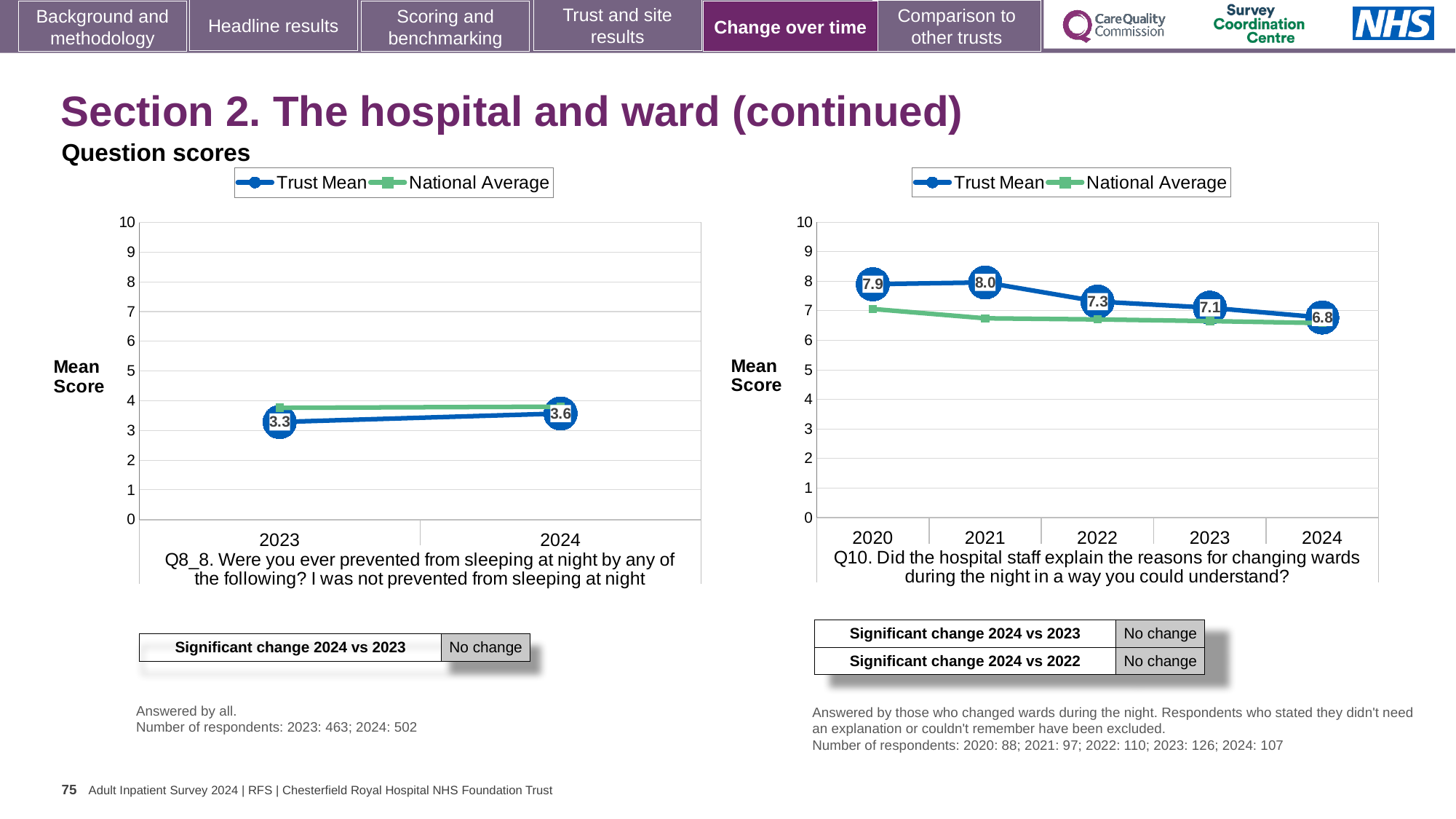
How many years are plotted on the x axis of the Q10 chart on the right? 5 In the Q10 chart on the right, is the Trust Mean for 2022 greater or less than the National Average for 2022? greater In the Q10 chart on the right, which year has the lowest Trust Mean score? 2024 In the Q10 chart on the right, what is the Trust Mean score for 2021? 8.0 In the Q10 chart on the right, what is the Trust Mean score for 2024? 6.8 In the Q8_8 chart on the left, what is the Trust Mean score for 2024? 3.6 In the Q8_8 chart on the left, does the Trust Mean rise or fall from 2023 to 2024? rise In the Q10 chart on the right, what is the difference between the Trust Mean in 2020 and in 2024? 1.1 In the Q10 chart on the right, which year has the highest Trust Mean score? 2021 In the Q8_8 chart on the left, by how much did the Trust Mean change from 2023 to 2024? 0.3 What type of chart is used for the Q8_8 chart on the left? line chart In the Q8_8 chart on the left, what is the Trust Mean score for 2023? 3.3